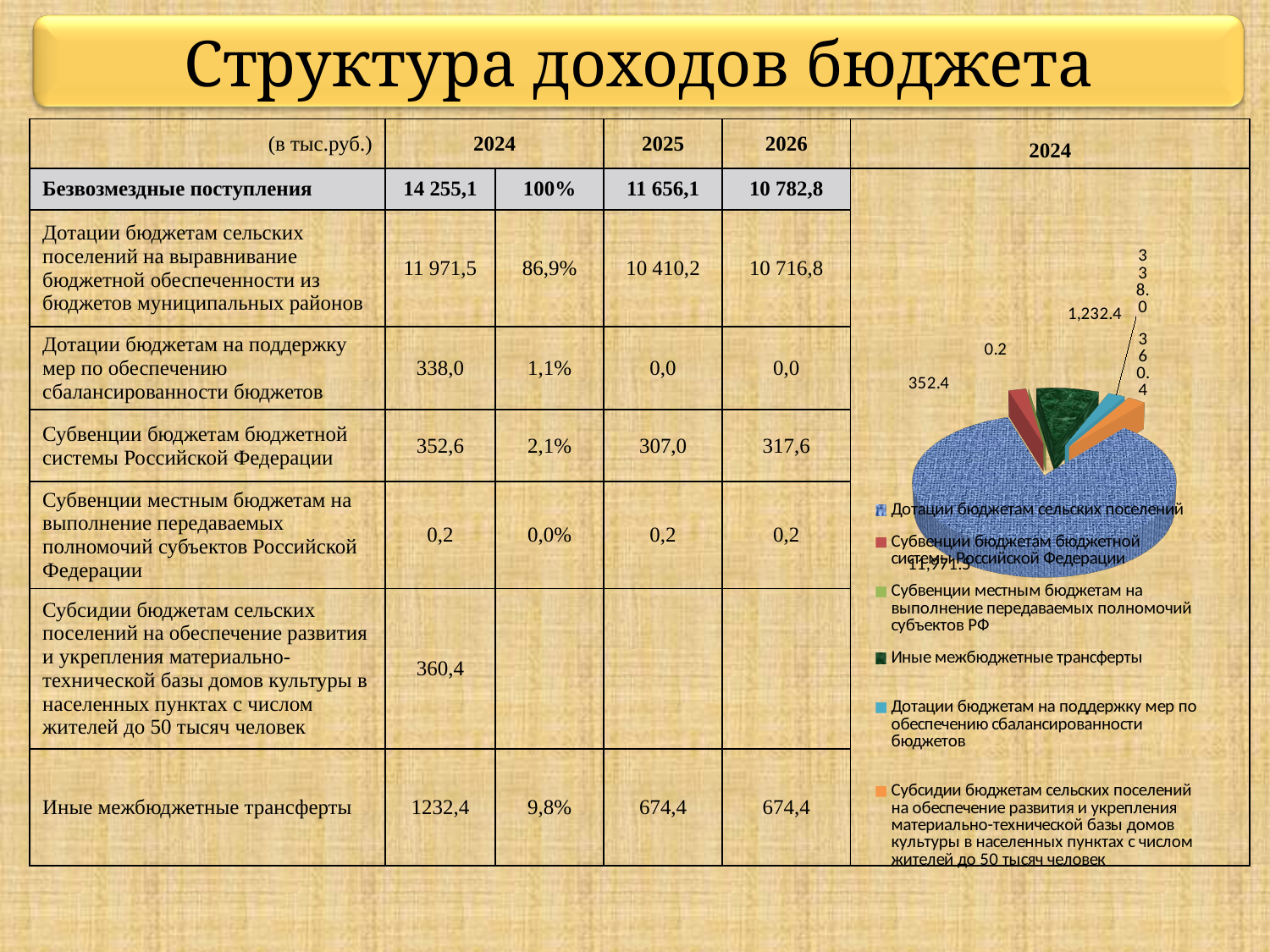
How many entries does the legend of the pie chart list? 6 In the pie chart, which is larger: Иные межбюджетные трансферты or Субвенции бюджетам бюджетной системы Российской Федерации? Иные межбюджетные трансферты In the pie chart, what value is labelled for Субвенции местным бюджетам на выполнение передаваемых полномочий субъектов РФ? 0.2 In the pie chart, what is the difference between the labelled values for Иные межбюджетные трансферты (1,232.4) and Субвенции бюджетам бюджетной системы Российской Федерации (352.4)? 880.0 In the pie chart, which category has the smallest slice? Субвенции местным бюджетам на выполнение передаваемых полномочий субъектов РФ In the pie chart, what value is labelled for Иные межбюджетные трансферты? 1,232.4 What colour is the largest slice of the pie chart? blue What kind of chart is shown on the right side of the slide? pie chart How many slices does the pie chart have? 6 In the pie chart, what value is labelled for Дотации бюджетам сельских поселений? 11,971.5 What is the title of the pie chart? 2024 In the pie chart, which category has the largest slice? Дотации бюджетам сельских поселений